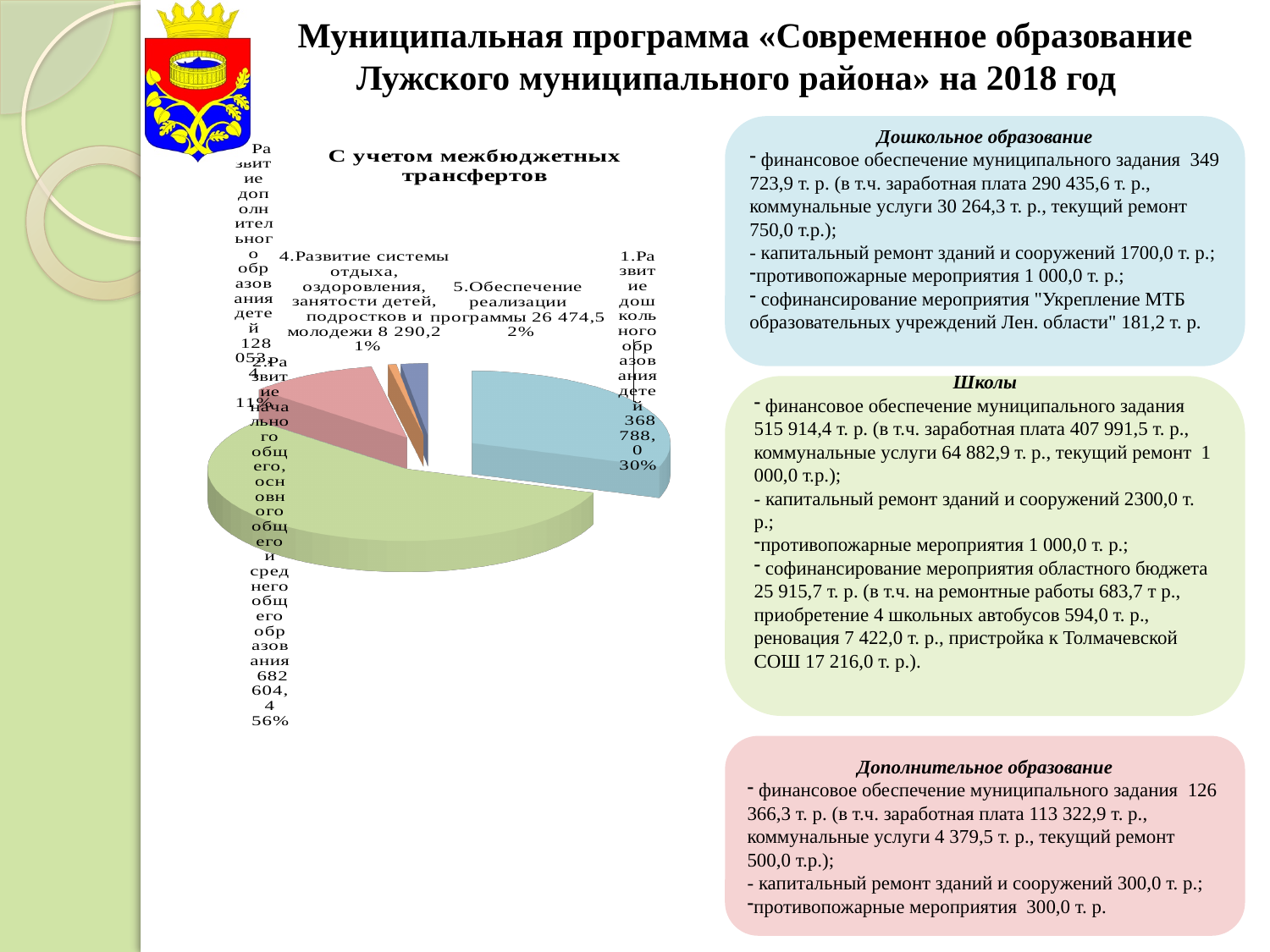
Which slice of the pie chart is the largest? 2.Развитие начального общего, основного общего и среднего общего образования What is the title of the pie chart? С учетом межбюджетных трансфертов What share of the pie does "1.Развитие дошкольного образования детей" take? 30% What kind of chart is shown on the slide? pie chart What value is shown for "5.Обеспечение реализации программы"? 26 474,5 What value is shown for "1.Развитие дошкольного образования детей"? 368 788,0 What percentage is shown for "2.Развитие начального общего, основного общего и среднего общего образования"? 56% Which is larger: the value for "1.Развитие дошкольного образования детей" or for "3.Развитие дополнительного образования детей"? 1.Развитие дошкольного образования детей What percentage is shown for "4.Развитие системы отдыха, оздоровления, занятости детей, подростков и молодежи"? 1% What value is shown for "3.Развитие дополнительного образования детей"? 128 053,4 How many slices does the pie chart have? 5 Which slice of the pie chart is the smallest? 4.Развитие системы отдыха, оздоровления, занятости детей, подростков и молодежи